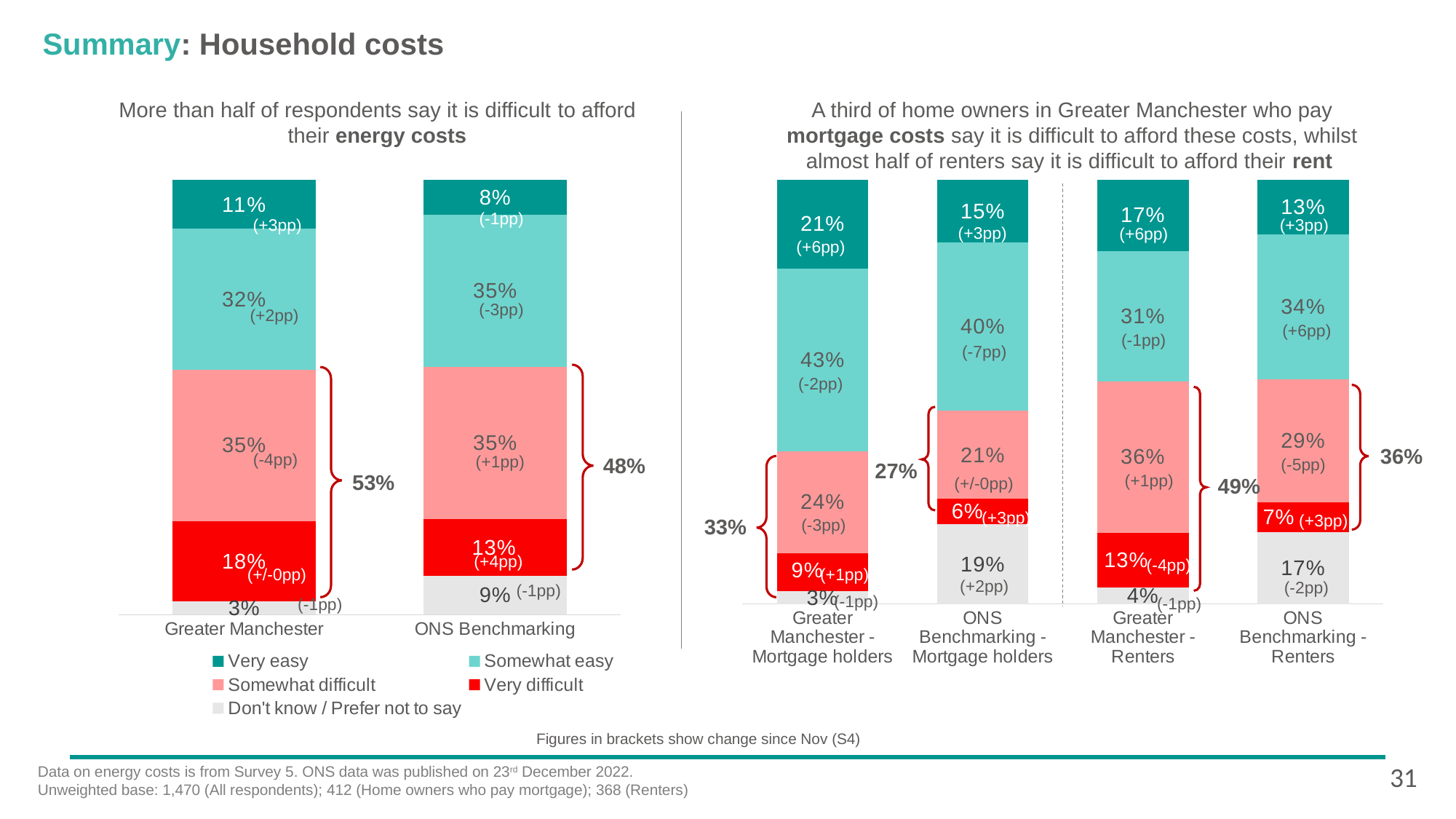
What type of chart is used on the left to show energy cost affordability? Stacked bar chart In the energy costs chart on the left, what percentage of ONS Benchmarking respondents say it is somewhat easy to afford their energy costs? 35% In the mortgage and rent chart on the right, how many bars (groups) are plotted? 4 In the energy costs chart on the left, what is the combined share of Greater Manchester respondents who find energy costs difficult (somewhat or very), as shown by the bracket? 53% In the energy costs chart on the left, what is the difference between the 'Very easy' percentages for Greater Manchester and ONS Benchmarking? 3 percentage points In the mortgage and rent chart on the right, which of the four groups has the largest 'Very easy' share? Greater Manchester - Mortgage holders In the mortgage and rent chart on the right, what percentage of Greater Manchester renters find it difficult (somewhat or very) to afford their rent, as shown by the bracket? 49% In the energy costs chart on the left, what percentage of Greater Manchester respondents say it is very difficult to afford their energy costs? 18% In the energy costs chart on the left, which is larger: the 'Don't know / Prefer not to say' share for Greater Manchester or for ONS Benchmarking? ONS Benchmarking In the mortgage and rent chart on the right, what percentage of Greater Manchester mortgage holders say it is somewhat easy to afford their mortgage costs? 43% In the mortgage and rent chart on the right, what is the difference between the 'Very difficult' shares for Greater Manchester renters and ONS Benchmarking renters? 6 percentage points In the energy costs chart on the left, how many series does the legend list? 5